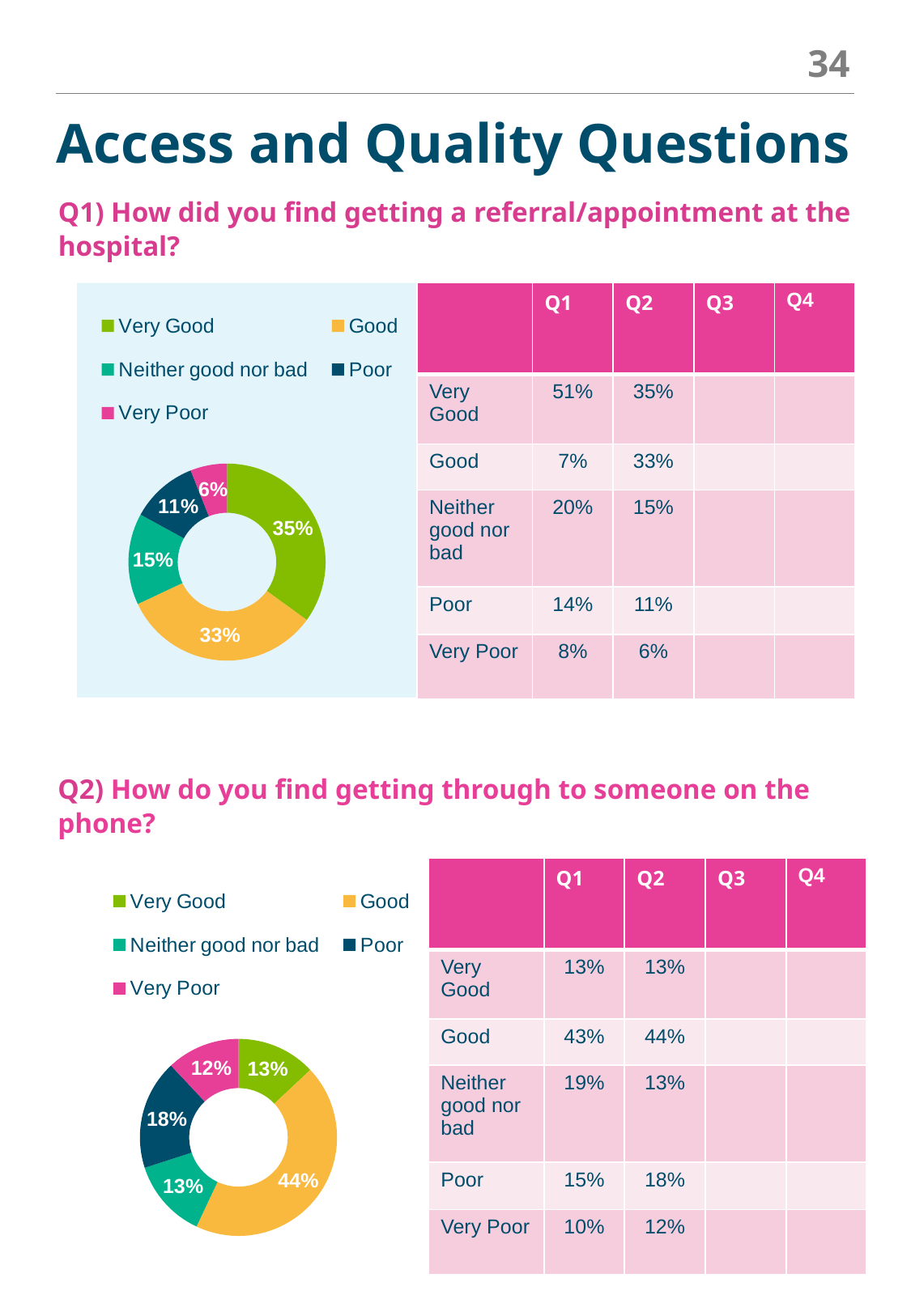
In the doughnut chart under Q1 (referral/appointment at the hospital), how many slices does the chart have? 5 In the doughnut chart under Q2 (getting through to someone on the phone), what percentage is shown for Good? 44% What type of chart is used under Q1 (referral/appointment at the hospital)? Doughnut chart In the doughnut chart under Q2 (getting through to someone on the phone), what is the difference between the Good slice and the Very Good slice? 31% In the doughnut chart under Q1 (referral/appointment at the hospital), what percentage is shown for Good? 33% In the doughnut chart under Q2 (getting through to someone on the phone), which category has the largest slice? Good In the doughnut chart under Q2 (getting through to someone on the phone), what percentage is shown for Poor? 18% In the doughnut chart under Q1 (referral/appointment at the hospital), which category has the smallest slice? Very Poor In the doughnut chart under Q1 (referral/appointment at the hospital), what percentage is shown for Very Good? 35% In the doughnut chart under Q2 (getting through to someone on the phone), is the Poor slice larger or smaller than the Very Poor slice? Larger In the doughnut chart under Q1 (referral/appointment at the hospital), what is the difference between the Neither good nor bad slice and the Poor slice? 4% How many entries does the legend of the doughnut chart under Q2 (getting through to someone on the phone) list? 5